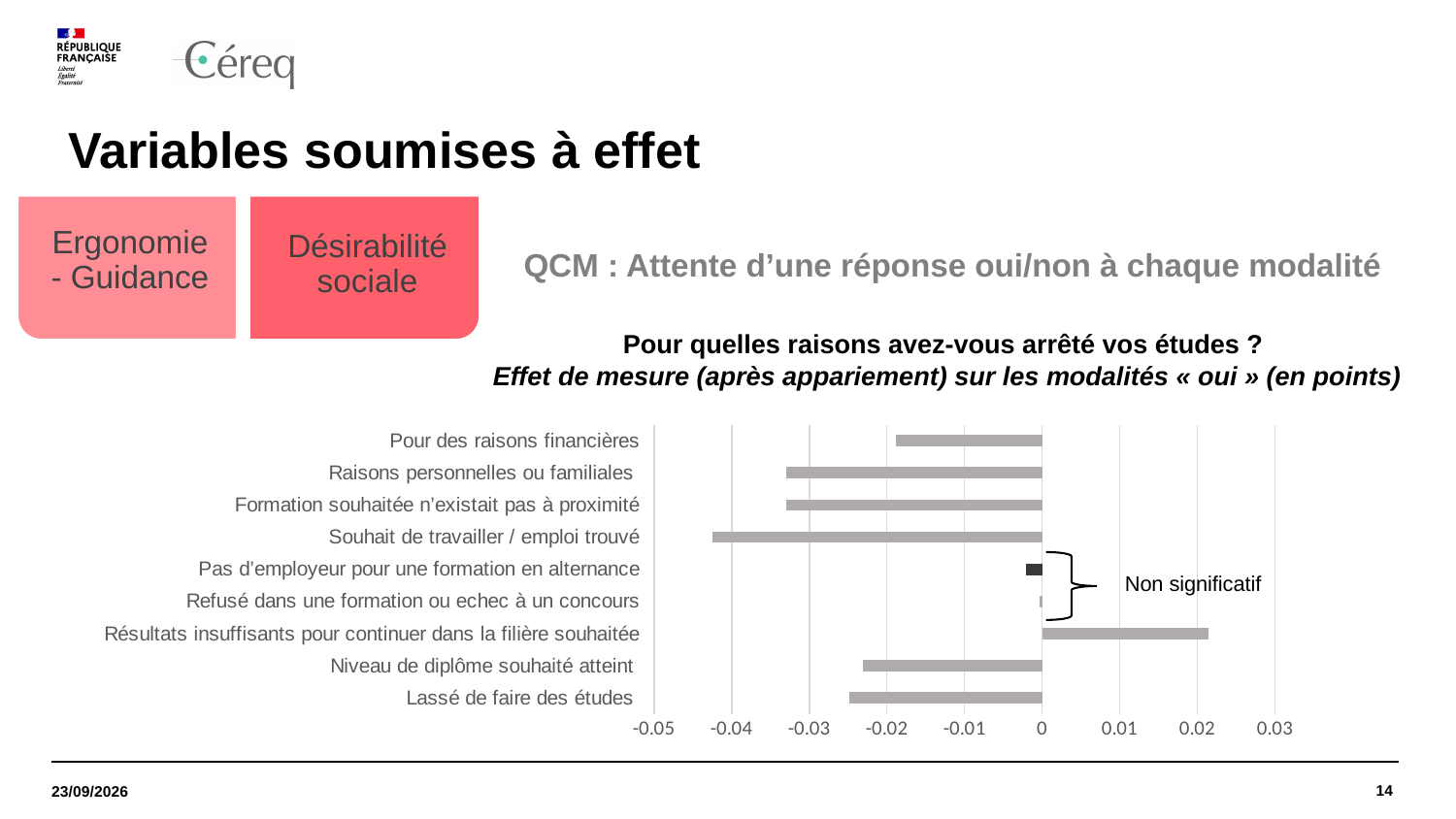
Which two categories are marked as 'Non significatif' in the chart? Pas d'employeur pour une formation en alternance; Refusé dans une formation ou echec à un concours Which has the larger value: 'Pour des raisons financières' or 'Souhait de travailler / emploi trouvé'? Pour des raisons financières Is the value for 'Pour des raisons financières' greater or less than -0.03? greater What kind of chart is shown on the slide? Bar chart Is the value for 'Lassé de faire des études' greater or less than -0.02? less Is the value for 'Raisons personnelles ou familiales' greater or less than -0.03? less How many categories have a positive value in the chart? 1 Which category has the highest value in the chart? Résultats insuffisants pour continuer dans la filière souhaitée Which category has the lowest (most negative) value in the chart? Souhait de travailler / emploi trouvé How many categories (reasons) are plotted in the chart? 9